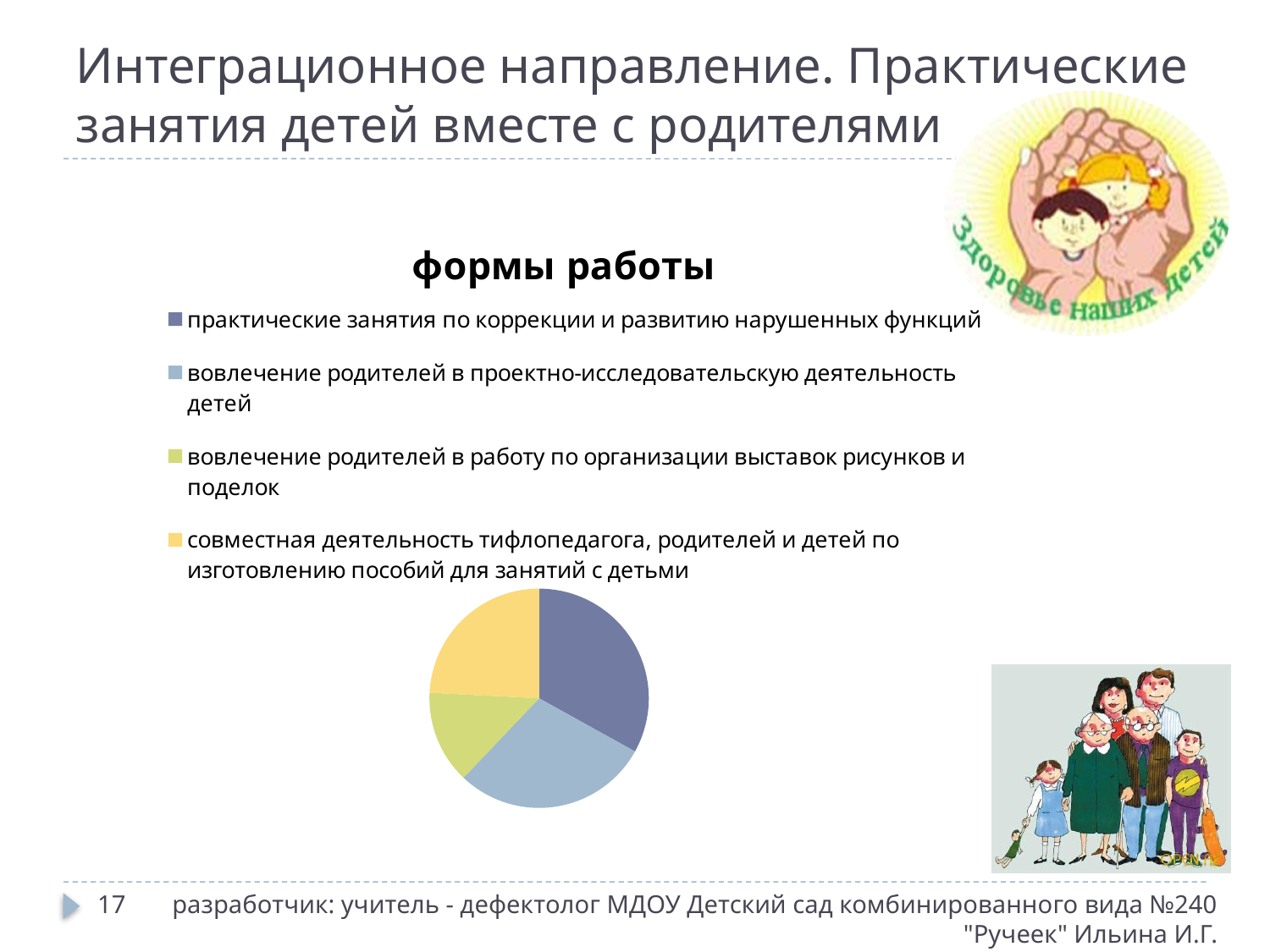
Which slice is larger: "совместная деятельность тифлопедагога, родителей и детей по изготовлению пособий для занятий с детьми" or "вовлечение родителей в работу по организации выставок рисунков и поделок"? совместная деятельность тифлопедагога, родителей и детей по изготовлению пособий для занятий с детьми Which category has the largest slice of the pie? практические занятия по коррекции и развитию нарушенных функций How many categories does the pie chart have? 4 Which category has the smallest slice of the pie? вовлечение родителей в работу по организации выставок рисунков и поделок Which slice is larger: "вовлечение родителей в проектно-исследовательскую деятельность детей" or "вовлечение родителей в работу по организации выставок рисунков и поделок"? вовлечение родителей в проектно-исследовательскую деятельность детей What kind of chart is shown on the slide? pie chart What is the title of the chart? формы работы Which slice is larger: "практические занятия по коррекции и развитию нарушенных функций" or "вовлечение родителей в работу по организации выставок рисунков и поделок"? практические занятия по коррекции и развитию нарушенных функций Which category is shown in yellow in the pie chart? совместная деятельность тифлопедагога, родителей и детей по изготовлению пособий для занятий с детьми